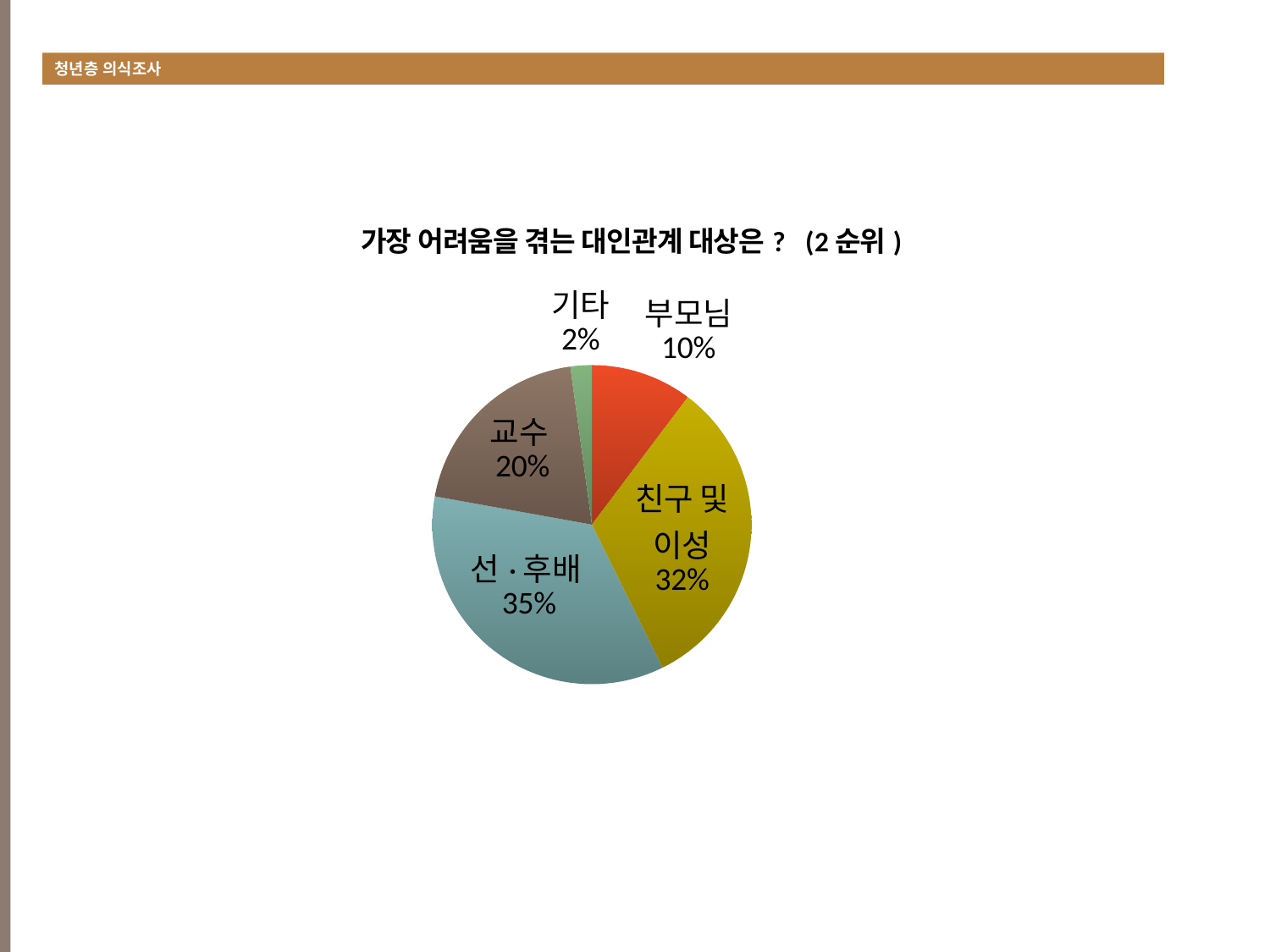
Which category has the smallest slice of the pie? 기타 How many categories are shown in the pie chart? 5 What is the difference between the values for 선·후배 and 친구 및 이성? 3% What share of the pie does 선·후배 represent? 35% What is the title of the chart? 가장 어려움을 겪는 대인관계 대상은 ? (2 순위 ) Which category has the largest slice of the pie? 선·후배 What is the value shown for 교수? 20% What is the difference between the values for 교수 and 부모님? 10% What kind of chart is shown on the slide? Pie chart Which is larger, the value for 교수 or the value for 부모님? 교수 What is the value shown for 부모님? 10% What is the value shown for 친구 및 이성? 32%